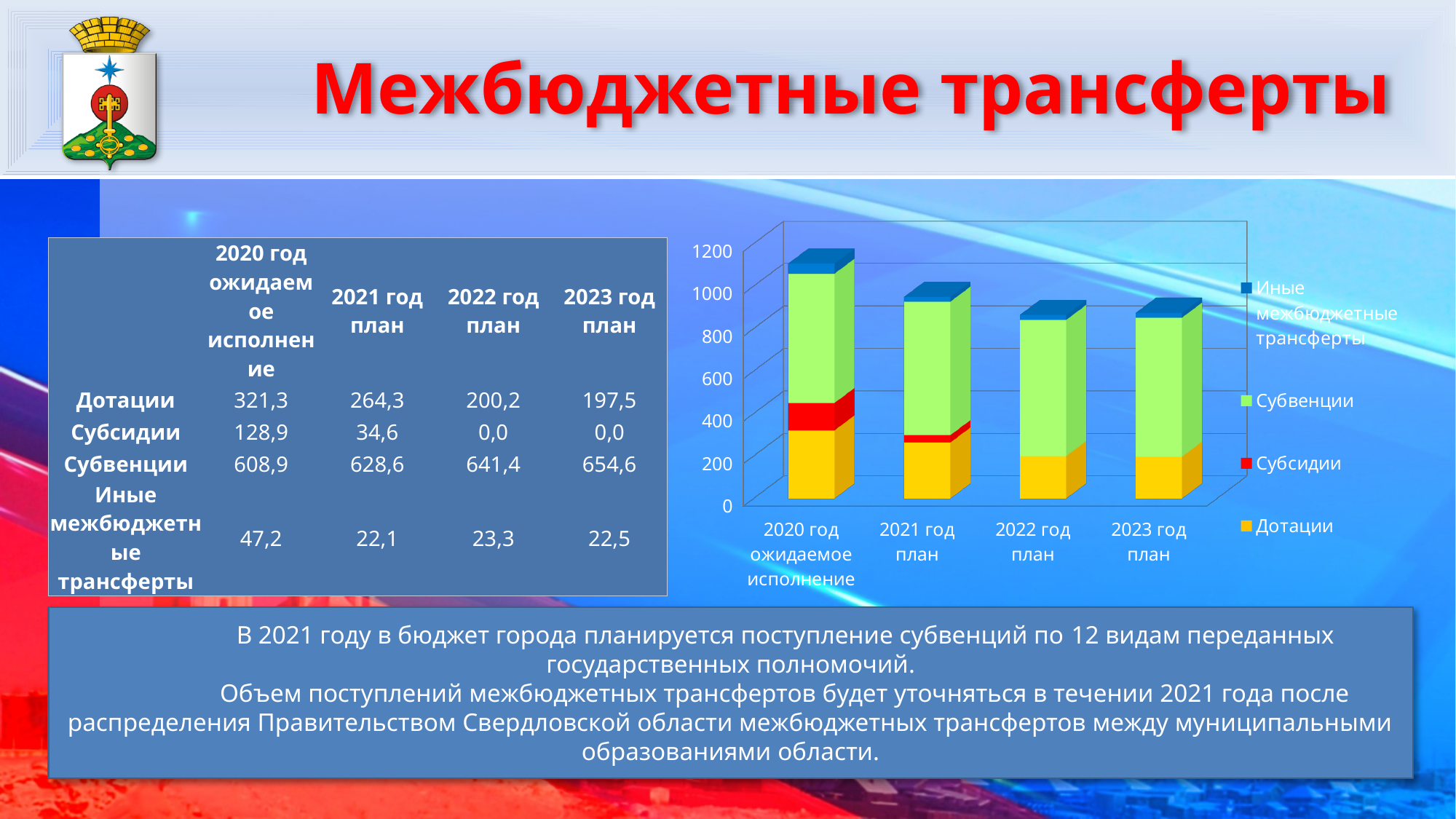
What kind of chart is shown on the slide? Stacked bar chart Which year has the tallest stacked bar in the chart? 2020 год ожидаемое исполнение How many series does the chart legend list? 4 What is the difference between Субсидии in 2020 год ожидаемое исполнение and in 2021 год план? 94,3 Do the values for Дотации rise or fall from 2020 to 2023? Fall Do the values for Субвенции rise or fall from 2020 to 2023? Rise Is the total of the stacked bar for 2021 год план greater or less than 1000? less What is the total of the stacked bar for 2020 год ожидаемое исполнение? 1106,3 What is the value of Дотации for 2020 год ожидаемое исполнение? 321,3 How many year categories are plotted along the x axis of the chart? 4 Which colour represents Субвенции in the chart? Green What is the value of Субвенции for 2023 год план? 654,6